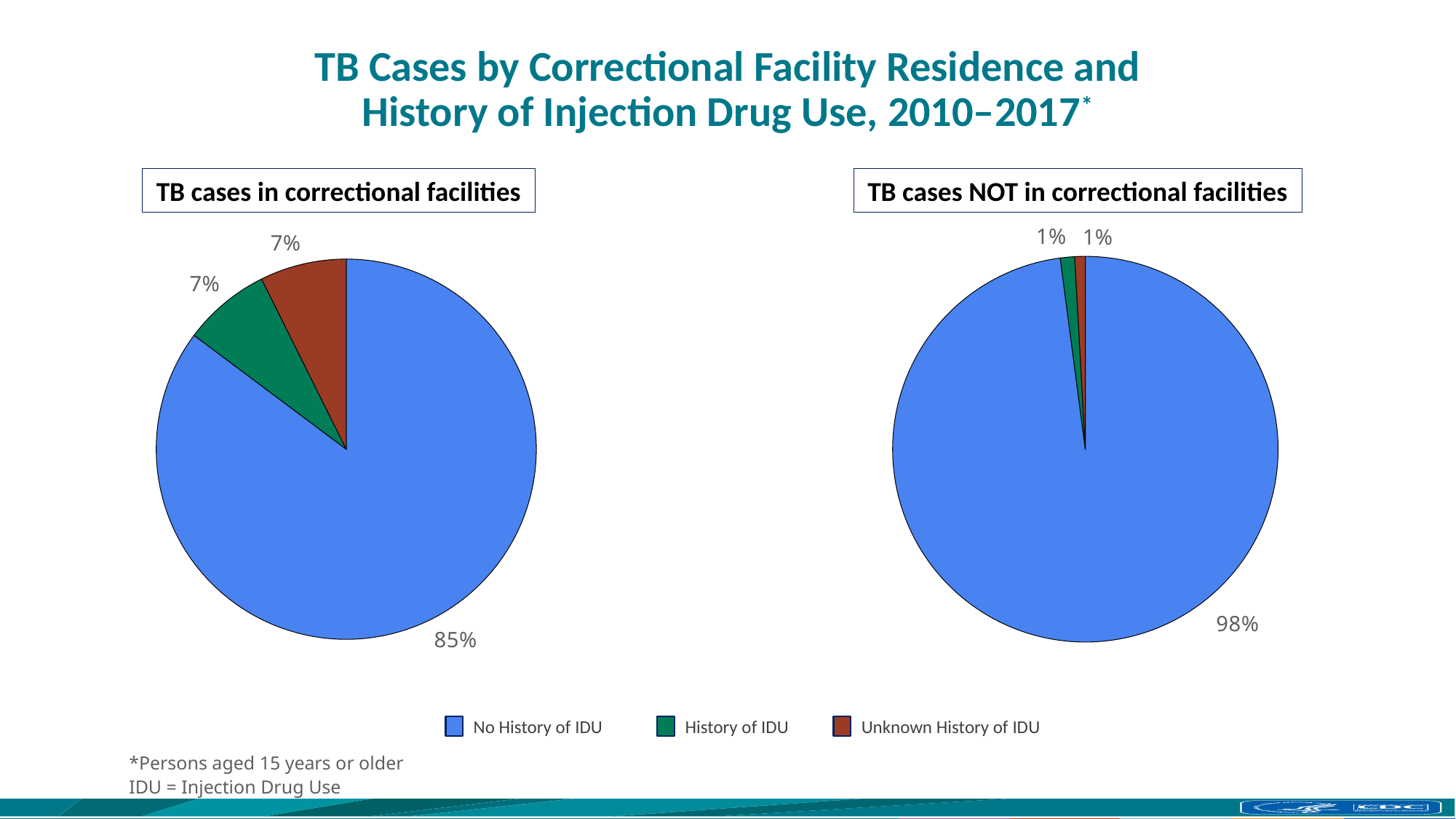
How many categories does the legend list for the pie charts? 3 In the 'TB cases NOT in correctional facilities' pie chart, which category has the largest slice? No History of IDU In the 'TB cases in correctional facilities' pie chart, which category has the largest slice? No History of IDU In the 'TB cases in correctional facilities' pie chart, what share of cases have an Unknown History of IDU? 7% Which chart has the larger share of cases with a History of IDU: 'TB cases in correctional facilities' or 'TB cases NOT in correctional facilities'? TB cases in correctional facilities In the 'TB cases NOT in correctional facilities' pie chart, what share of cases have No History of IDU? 98% In the 'TB cases in correctional facilities' pie chart, what share of cases have No History of IDU? 85% In the legend, which colour represents Unknown History of IDU? Red What type of chart is used for 'TB cases in correctional facilities'? Pie chart What is the difference between the No History of IDU share in the 'TB cases NOT in correctional facilities' chart and the No History of IDU share in the 'TB cases in correctional facilities' chart? 13%